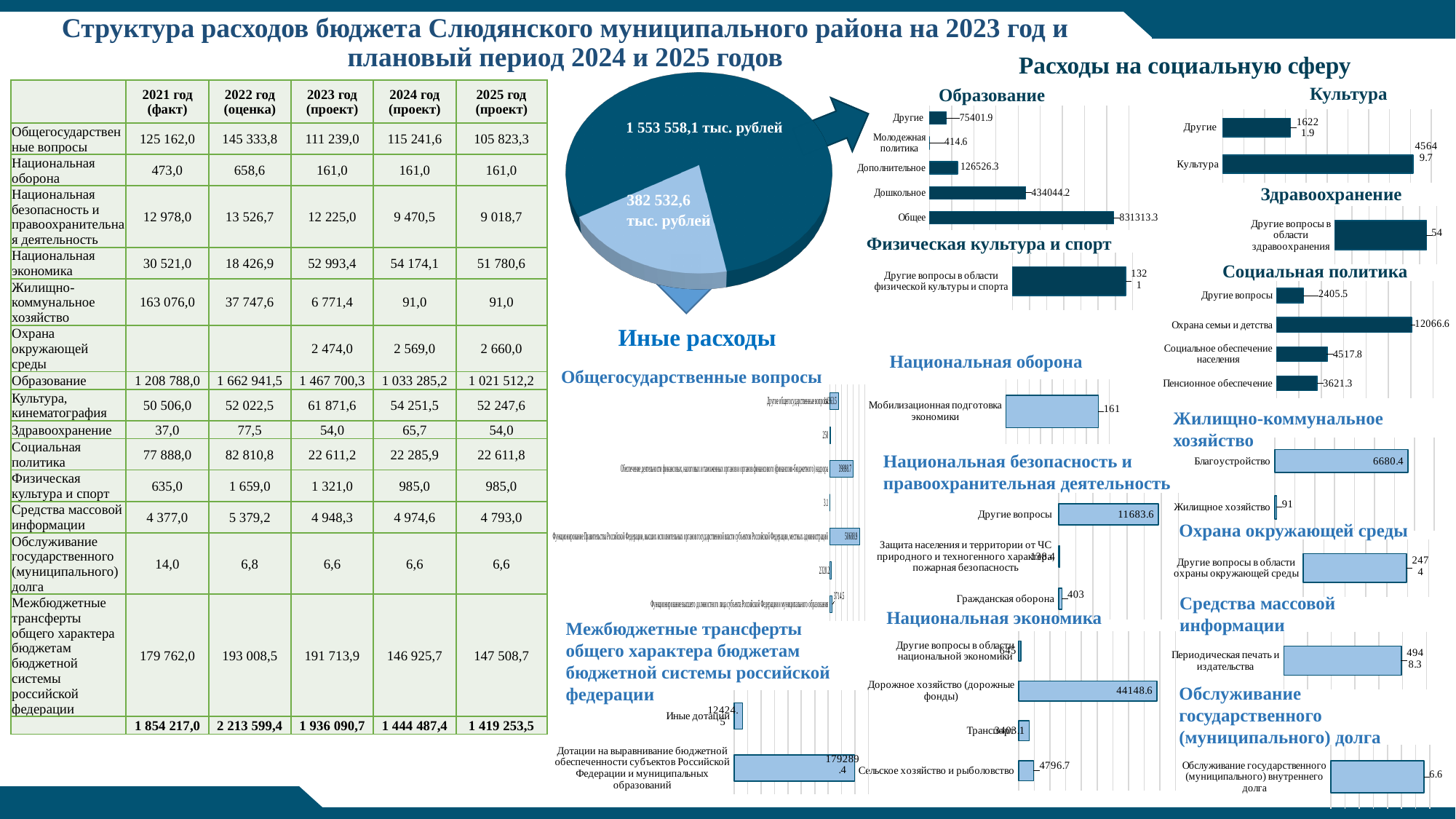
In the 'Образование' chart, which category has the lowest value? Молодежная политика In the 'Социальная политика' chart, which category has the lowest value? Другие вопросы How many categories are shown in the 'Образование' chart? 5 In the 'Социальная политика' chart, what is the value for 'Охрана семьи и детства'? 12066.6 In the 'Жилищно-коммунальное хозяйство' chart, what is the value for 'Благоустройство'? 6680.4 In the 'Социальная политика' chart, what is the difference between 'Социальное обеспечение населения' and 'Пенсионное обеспечение'? 896.5 In the 'Национальная экономика' chart, which is larger: 'Сельское хозяйство и рыболовство' or 'Другие вопросы в области национальной экономики'? Сельское хозяйство и рыболовство In the 'Национальная экономика' chart, what is the value for 'Дорожное хозяйство (дорожные фонды)'? 44148.6 In the 'Национальная оборона' chart, what is the value for 'Мобилизационная подготовка экономики'? 161 In the 'Образование' chart, which category has the highest value? Общее In the 'Образование' chart, what is the value for 'Общее'? 831313.3 What kind of chart is the 'Национальная безопасность и правоохранительная деятельность' chart? bar chart